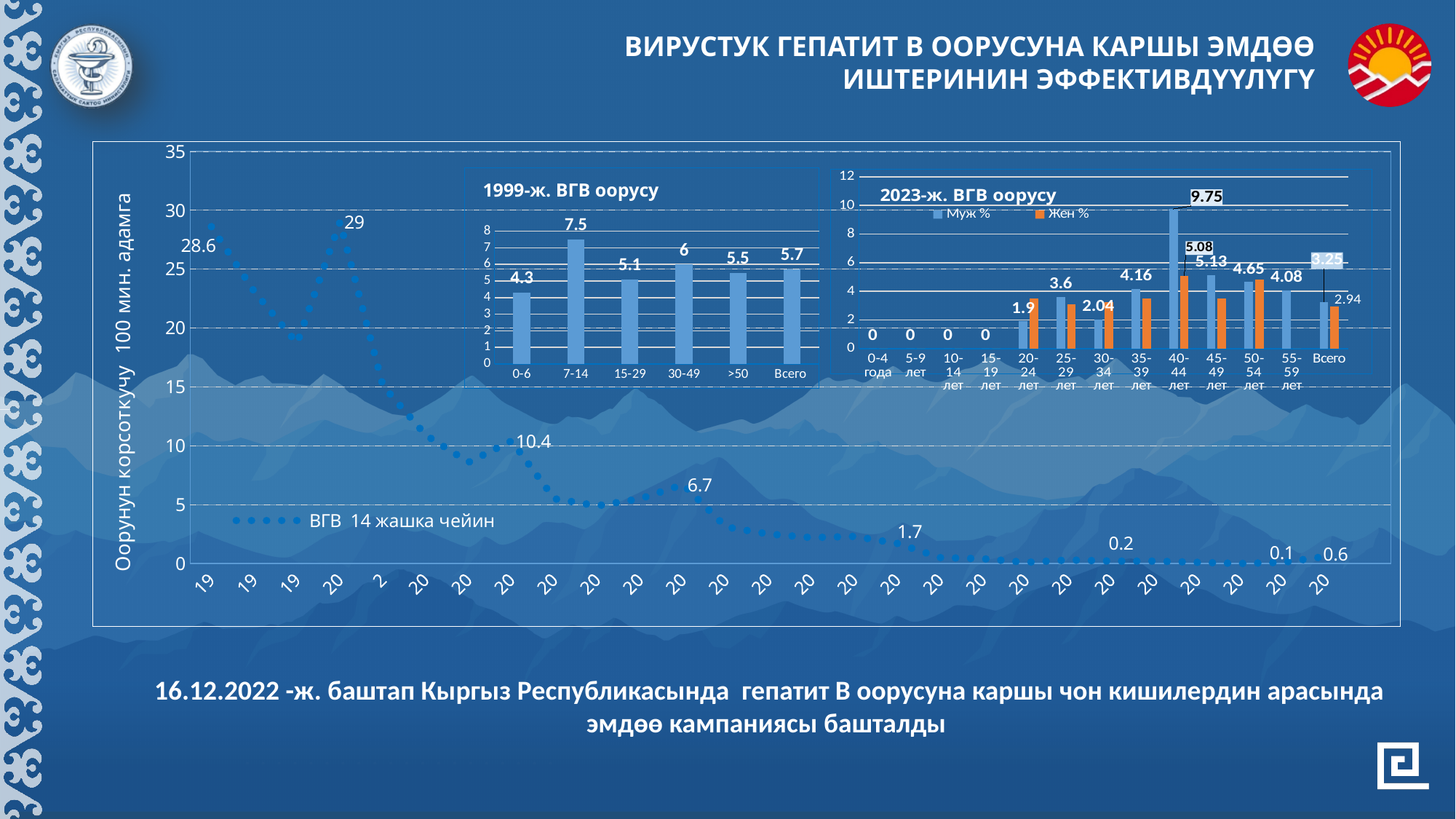
In the chart titled "2023-ж. ВГВ оорусу", which age group has the highest Муж % value? 40-44 лет In the chart titled "1999-ж. ВГВ оорусу", which age group has the highest value? 7-14 How many categories are shown on the x axis of the chart titled "1999-ж. ВГВ оорусу"? 6 Do the values on the large dotted line chart labelled "ВГВ 14 жашка чейин" generally rise or fall along the x axis? fall What is the highest labelled value on the large dotted line chart labelled "ВГВ 14 жашка чейин"? 29 In the chart titled "2023-ж. ВГВ оорусу", what is the Жен % value for the Всего category? 2.94 In the chart titled "1999-ж. ВГВ оорусу", what is the value for the 7-14 age group? 7.5 How many series does the legend of the chart titled "2023-ж. ВГВ оорусу" list? 2 In the chart titled "2023-ж. ВГВ оорусу", what is the Муж % value for the 40-44 лет group? 9.75 In the chart titled "2023-ж. ВГВ оорусу", is the Муж % value for 40-44 лет greater or less than 8? greater In the chart titled "1999-ж. ВГВ оорусу", which category has the lowest value? 0-6 In the chart titled "1999-ж. ВГВ оорусу", what is the difference between the values for 7-14 and 15-29? 2.4